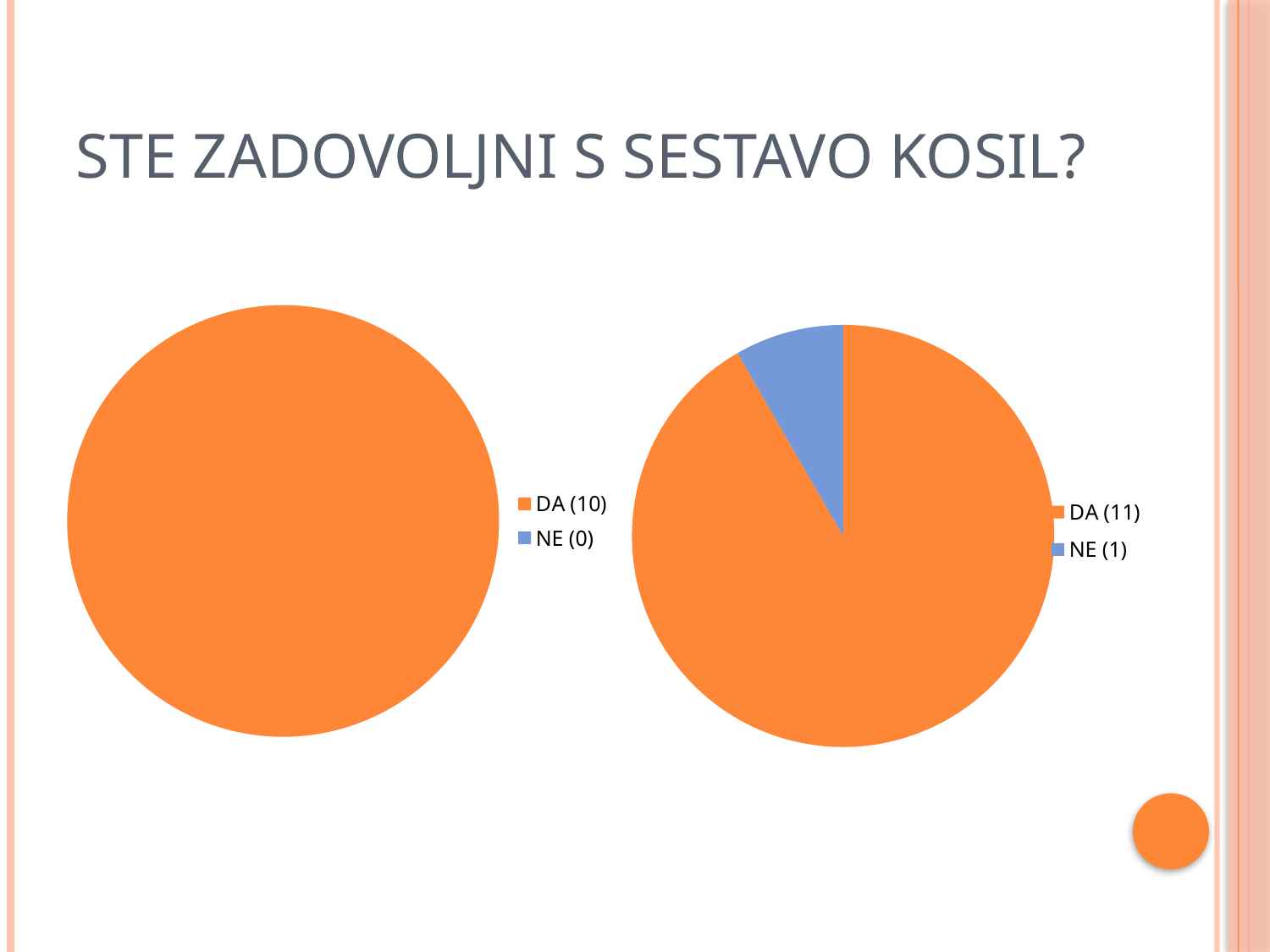
How many categories does the legend of the left pie chart list? 2 What kind of chart is the left chart on the slide? pie chart In the right pie chart, which category has the smallest slice? NE In the right pie chart, what is the difference between the DA and NE counts? 10 In the right pie chart, what is the total number of responses across DA and NE? 12 In the right pie chart, which is larger, DA or NE? DA What colour is the DA slice in the right pie chart? orange In the left pie chart, how many responses does the legend show for DA? 10 In the left pie chart, how many responses does the legend show for NE? 0 In the right pie chart, how many responses does the legend show for DA? 11 In the right pie chart, which category has the largest slice? DA In the right pie chart, how many responses does the legend show for NE? 1